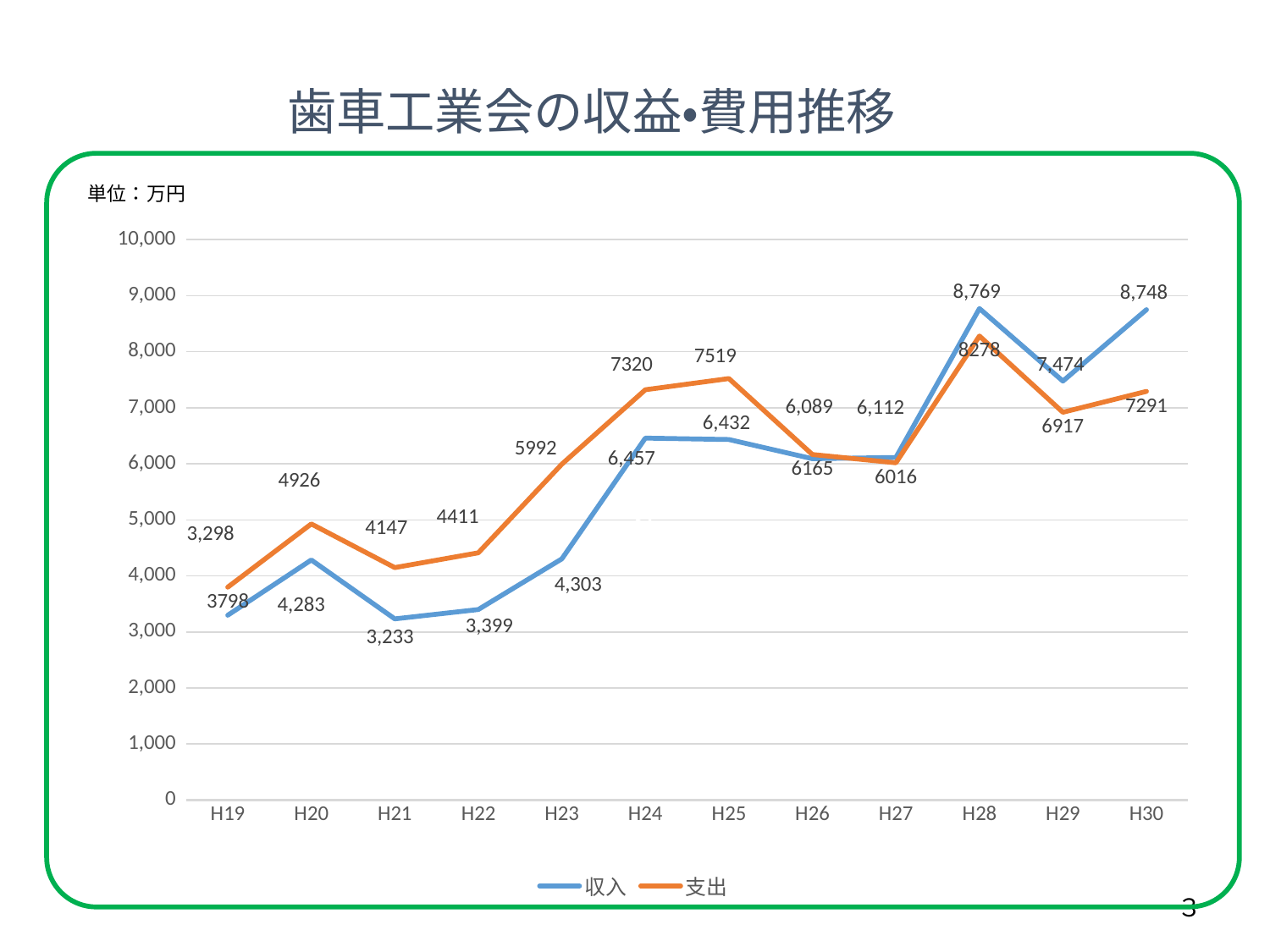
How many years are plotted on the x axis? 12 In which year is 支出 highest? H28 In H24, which is larger, 収入 or 支出? 支出 What is the 支出 value for H25? 7519 What is the difference between 収入 and 支出 in H30? 1,457 What kind of chart is shown? line chart In which year is 支出 lowest? H19 In which year is 収入 highest? H28 What is the 収入 value for H21? 3,233 How many series does the legend list? 2 What is the 収入 value for H28? 8,769 Is the 収入 value for H23 greater or less than 5,000? less